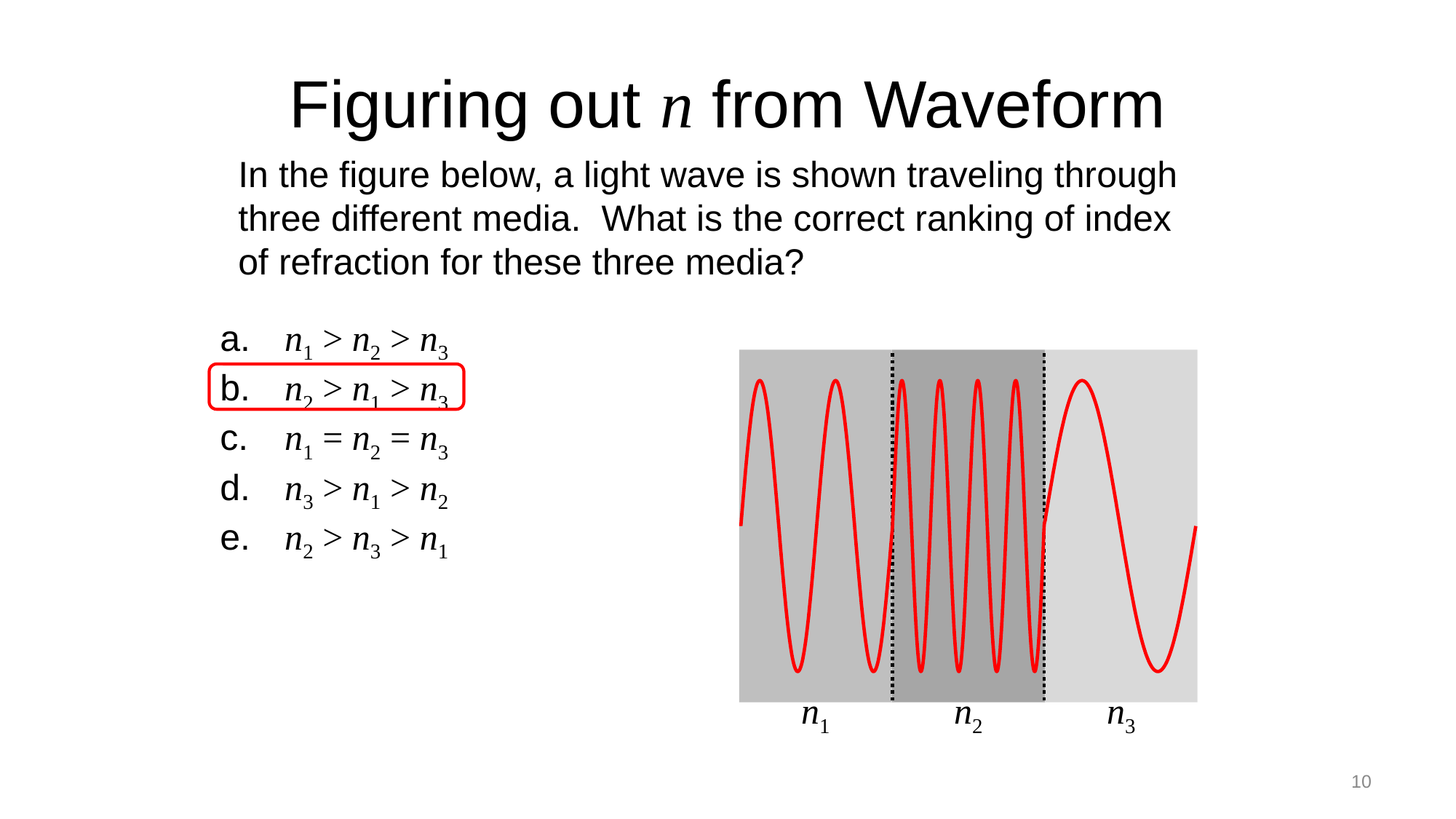
Is the wavelength of the wave in region n1 longer or shorter than in region n2? longer How many wave peaks appear inside the n1 region? 2 What are the labels of the three media regions in the figure, from left to right? n1, n2, n3 According to the circled answer on the slide, which medium has the highest index of refraction? n2 How many wave peaks appear inside the n2 region? 4 What colour is the wave drawn in the figure? red In which medium region does the wave have the shortest wavelength? n2 How many different media regions are shown in the waveform figure? 3 Is the wavelength of the wave in region n3 longer or shorter than in region n1? longer Does the wavelength increase or decrease as the wave passes from region n2 into region n3? increase In which medium region does the wave have the longest wavelength? n3